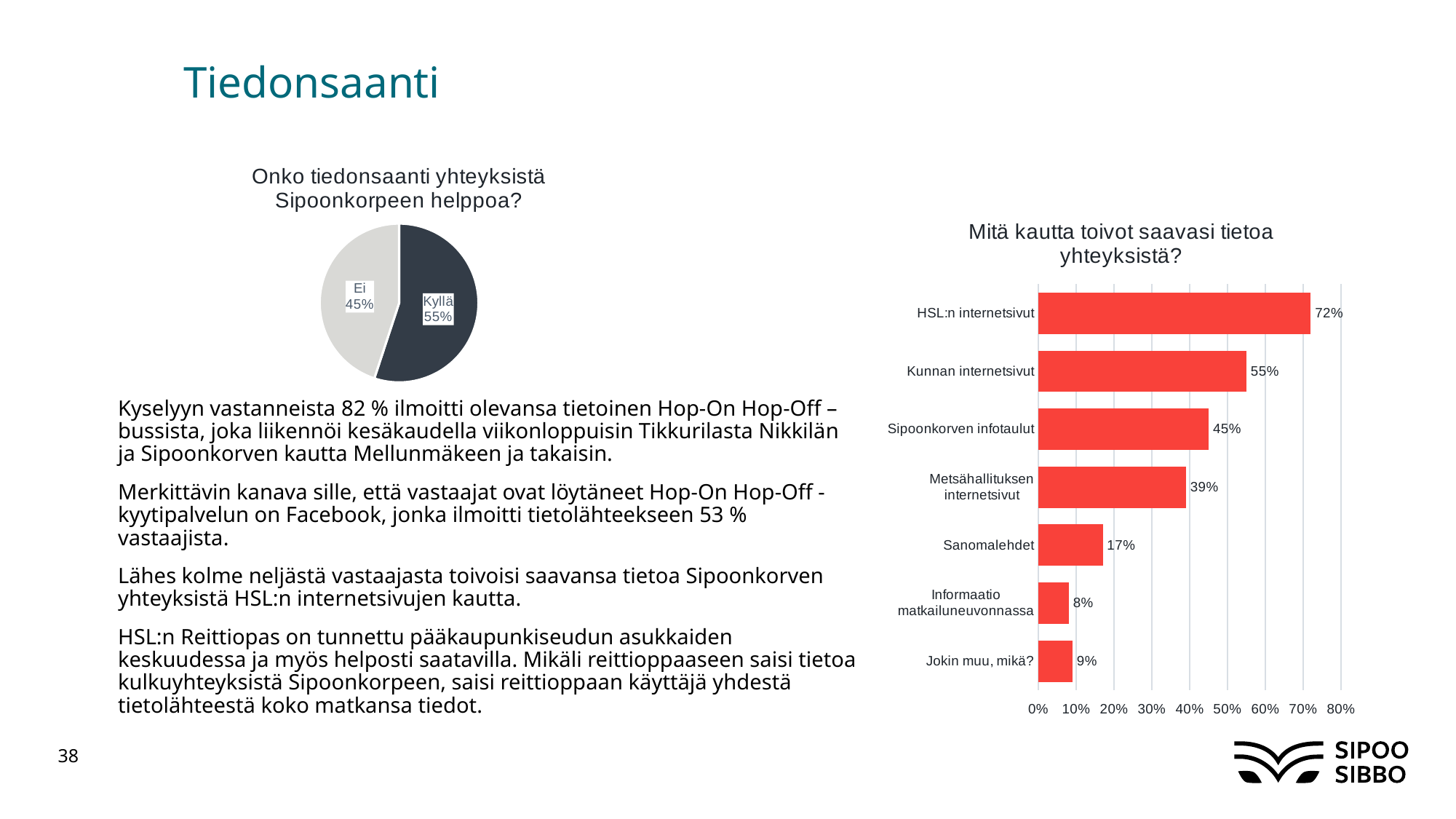
In the pie chart 'Onko tiedonsaanti yhteyksistä Sipoonkorpeen helppoa?', what is the value for 'Ei'? 45% In the bar chart 'Mitä kautta toivot saavasi tietoa yhteyksistä?', what is the value for 'Metsähallituksen internetsivut'? 39% In the bar chart 'Mitä kautta toivot saavasi tietoa yhteyksistä?', which category has the highest value? HSL:n internetsivut In the bar chart 'Mitä kautta toivot saavasi tietoa yhteyksistä?', which is larger: 'Sanomalehdet' or 'Jokin muu, mikä?'? Sanomalehdet In the bar chart 'Mitä kautta toivot saavasi tietoa yhteyksistä?', what is the difference between 'HSL:n internetsivut' and 'Sipoonkorven infotaulut'? 27% In the bar chart 'Mitä kautta toivot saavasi tietoa yhteyksistä?', how many categories are shown? 7 What kind of chart is the chart titled 'Mitä kautta toivot saavasi tietoa yhteyksistä?'? Bar chart In the bar chart 'Mitä kautta toivot saavasi tietoa yhteyksistä?', which category has the lowest value? Informaatio matkailuneuvonnassa In the bar chart 'Mitä kautta toivot saavasi tietoa yhteyksistä?', what is the value for 'Kunnan internetsivut'? 55% What kind of chart is the chart titled 'Onko tiedonsaanti yhteyksistä Sipoonkorpeen helppoa?'? Pie chart In the pie chart 'Onko tiedonsaanti yhteyksistä Sipoonkorpeen helppoa?', how many slices are there? 2 In the pie chart 'Onko tiedonsaanti yhteyksistä Sipoonkorpeen helppoa?', what share of respondents answered 'Kyllä'? 55%